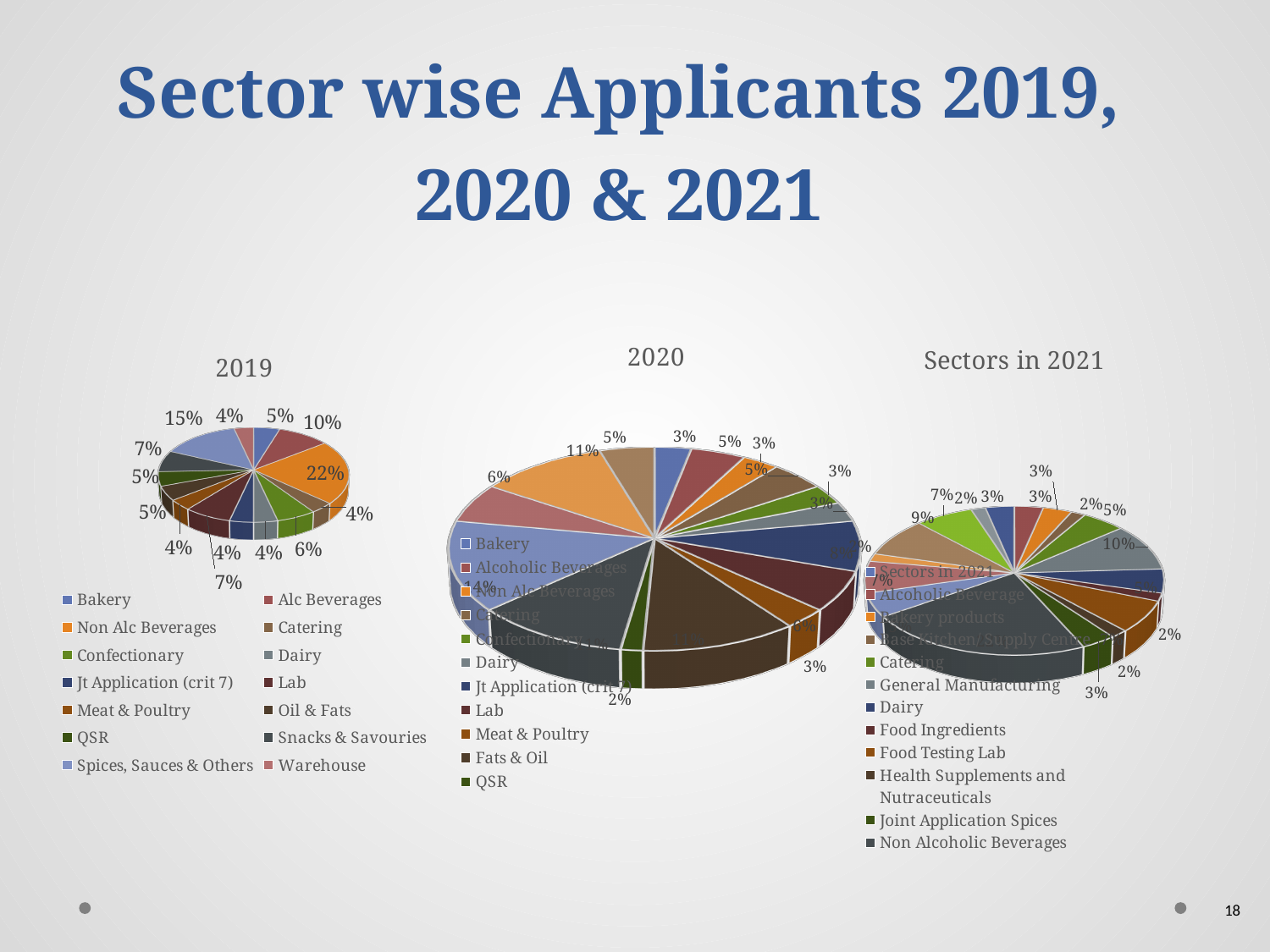
In the 2019 chart, what share is Lab? 7% In the 2019 chart, which is larger, Alc Beverages or Bakery? Alc Beverages In the 2019 chart, which sector has the largest share? Non Alc Beverages How many pie charts are shown on the slide? 3 In the 2019 chart, how many percentage points larger is Non Alc Beverages than Spices, Sauces & Others? 7 percentage points In the 2019 chart, what share is Spices, Sauces & Others? 15% What kind of chart is the 2019 chart? Pie chart In the 2020 chart, what share is Bakery? 3% How many sectors does the legend of the 2019 chart list? 14